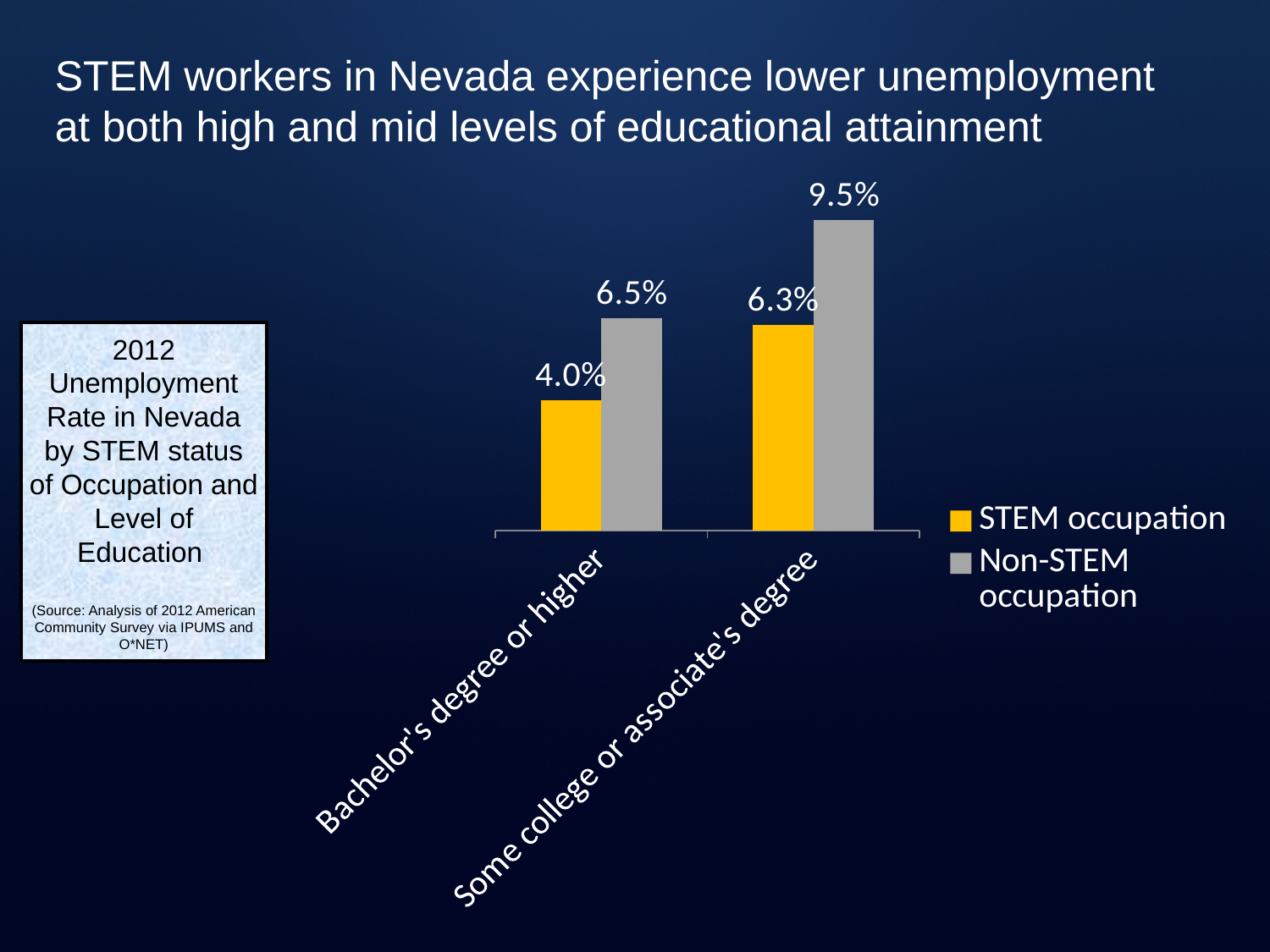
What is the difference between the Non-STEM and STEM unemployment rates for workers with some college or associate's degree? 3.2% What is the unemployment rate for Non-STEM occupation workers with a bachelor's degree or higher? 6.5% How many education level categories are shown on the x axis? 2 How many series does the legend list? 2 Which is larger: the STEM occupation rate for some college or associate's degree, or the Non-STEM occupation rate for bachelor's degree or higher? Non-STEM occupation rate for bachelor's degree or higher What type of chart is shown on the slide? Bar chart What is the difference between the Non-STEM and STEM unemployment rates for workers with a bachelor's degree or higher? 2.5% Which bar shows the highest unemployment rate on the chart? Non-STEM occupation, some college or associate's degree Which bar shows the lowest unemployment rate on the chart? STEM occupation, bachelor's degree or higher What is the unemployment rate for STEM occupation workers with some college or associate's degree? 6.3% What is the unemployment rate for STEM occupation workers with a bachelor's degree or higher? 4.0% What is the unemployment rate for Non-STEM occupation workers with some college or associate's degree? 9.5%